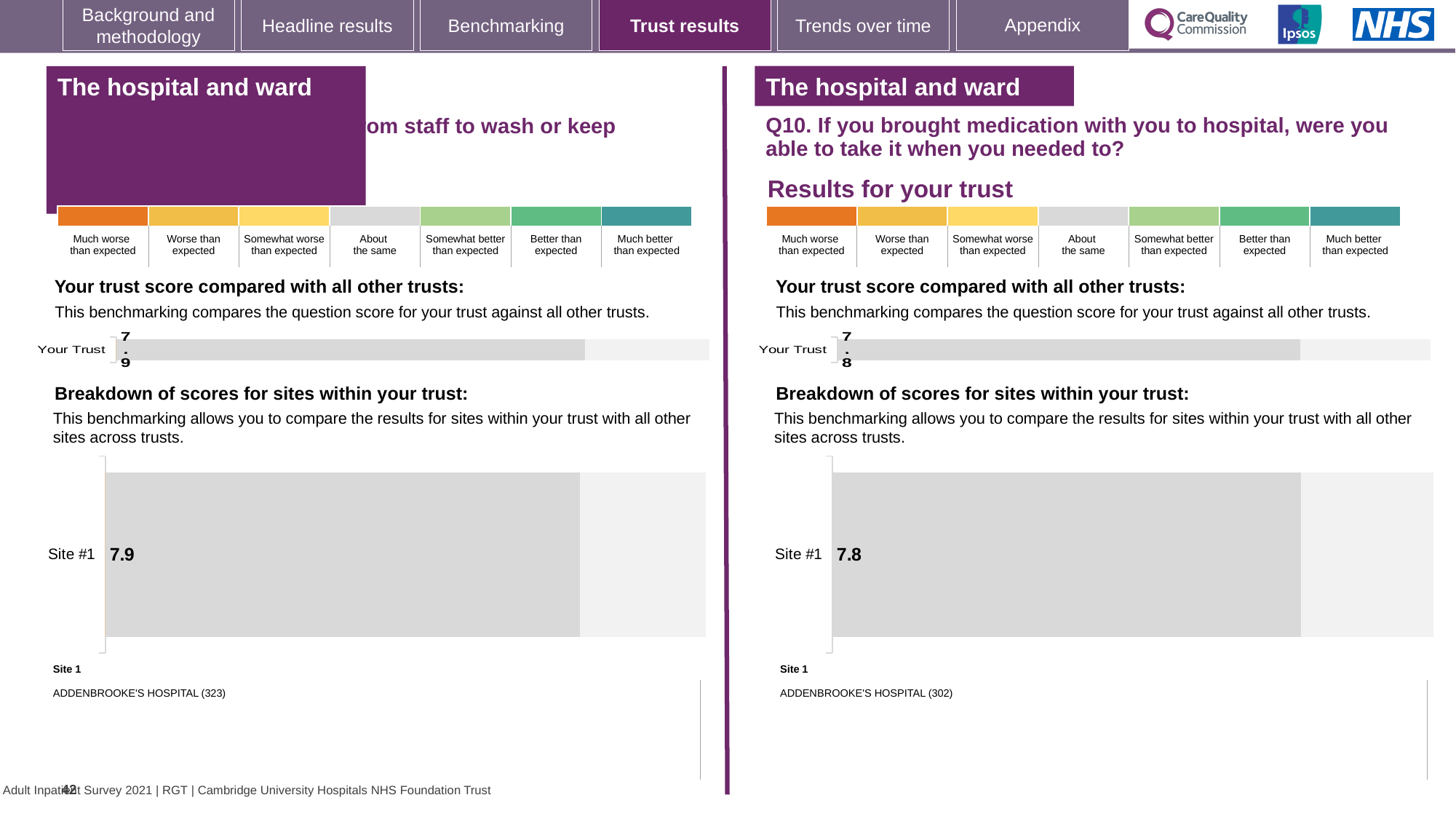
What type of chart is used for the 'Breakdown of scores for sites within your trust' on the right half of the slide? Bar chart On the right half of the slide (Q10, medication), what is the score shown for Your Trust in the 'Your trust score compared with all other trusts' chart? 7.8 Which is larger: the Site #1 score in the left-hand breakdown chart or the Site #1 score in the right-hand (Q10) breakdown chart? Left-hand chart (7.9) On the left half of the slide, what score is shown for Site #1 in the 'Breakdown of scores for sites within your trust' chart? 7.9 On the right half of the slide (Q10, medication), what score is shown for Site #1 in the 'Breakdown of scores for sites within your trust' chart? 7.8 What is the difference between the Site #1 score in the left-hand breakdown chart and the Site #1 score in the right-hand (Q10) breakdown chart? 0.1 What is the name of the site listed as Site 1 below the right-hand (Q10) breakdown chart? ADDENBROOKE'S HOSPITAL (302) How many sites are plotted in the right-hand (Q10) 'Breakdown of scores for sites within your trust' chart? 1 What is the name of the site listed as Site 1 below the left-hand breakdown chart? ADDENBROOKE'S HOSPITAL (323) How many sites are plotted in the left-hand 'Breakdown of scores for sites within your trust' chart? 1 On the left half of the slide, what is the score shown for Your Trust in the 'Your trust score compared with all other trusts' chart? 7.9